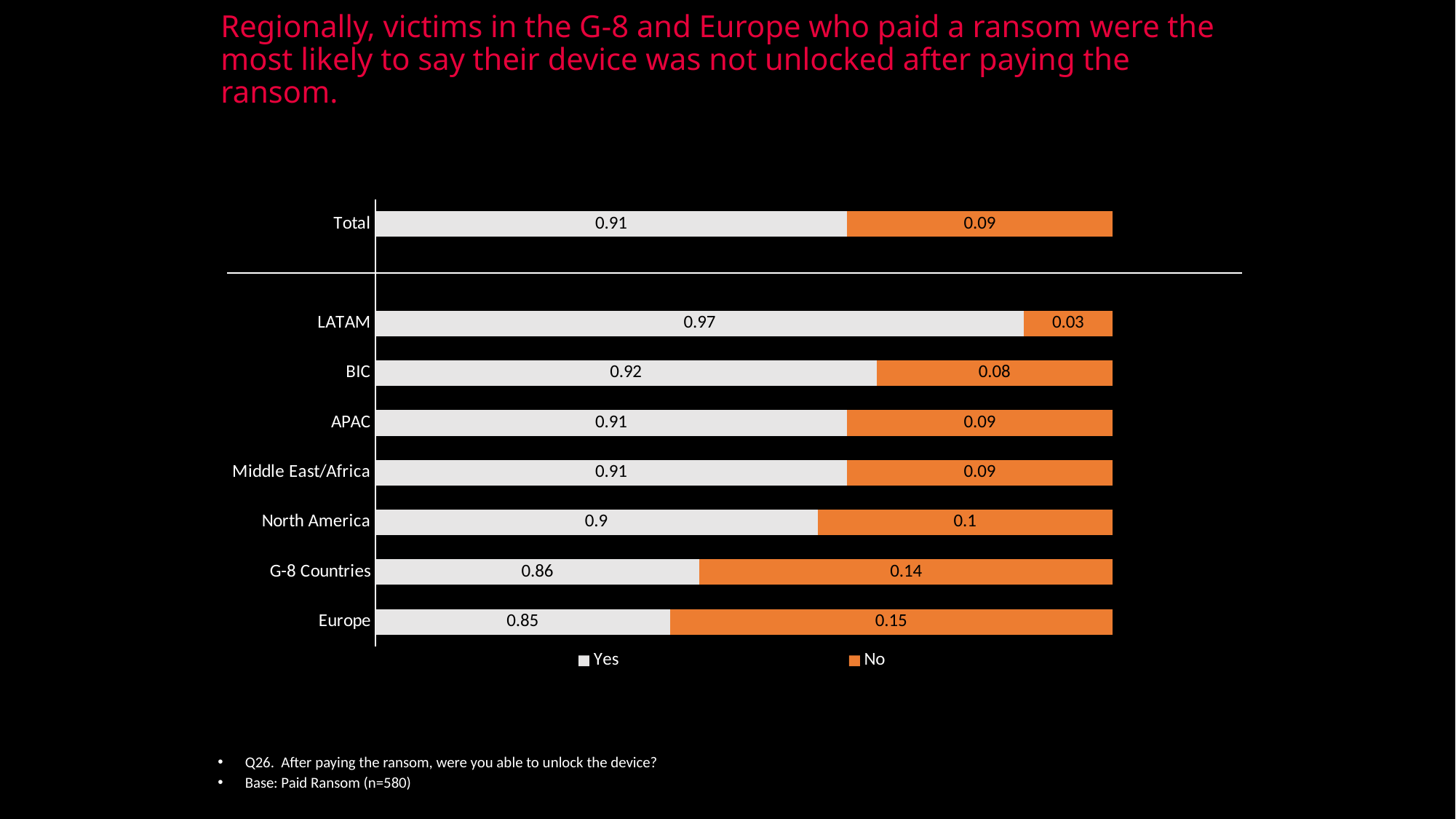
What is the 'No' value for G-8 Countries? 0.14 What is the total of the stacked bar for Total? 1 What is the 'Yes' value for North America? 0.9 Which region has the lowest 'No' value? LATAM Is the 'No' value larger for BIC or for G-8 Countries? G-8 Countries Which region has the highest 'No' value? Europe Which region has the highest 'Yes' value? LATAM How many series does the legend list? 2 What is the difference between the 'Yes' values for LATAM and Europe? 0.12 What is the 'Yes' value for LATAM? 0.97 What kind of chart is shown on the slide? Stacked bar chart What is the 'No' value for Europe? 0.15